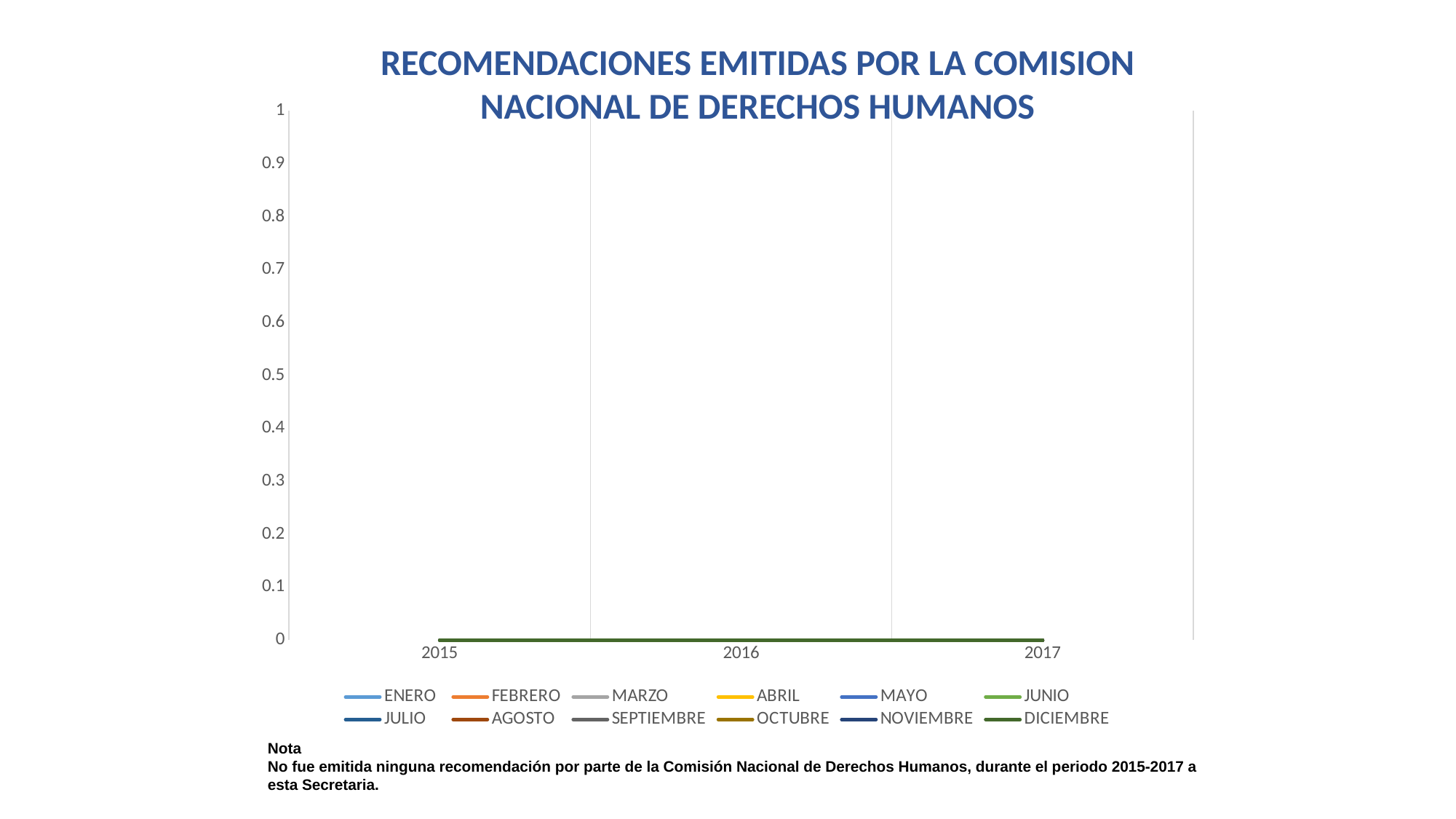
What is the value for JUNIO in 2017? 0 Do the plotted values rise, fall, or stay flat from 2015 to 2017? stay flat Is the value for DICIEMBRE in 2017 greater or less than 0.5? less What kind of chart is shown on the slide? line chart What is the highest value shown on the y axis? 1 Which year is the first category on the x axis? 2015 What is the value for DICIEMBRE in 2016? 0 What is the title of the chart? RECOMENDACIONES EMITIDAS POR LA COMISION NACIONAL DE DERECHOS HUMANOS What is the difference between the DICIEMBRE value in 2015 and in 2017? 0 How many series does the legend list? 12 How many years are shown on the x axis? 3